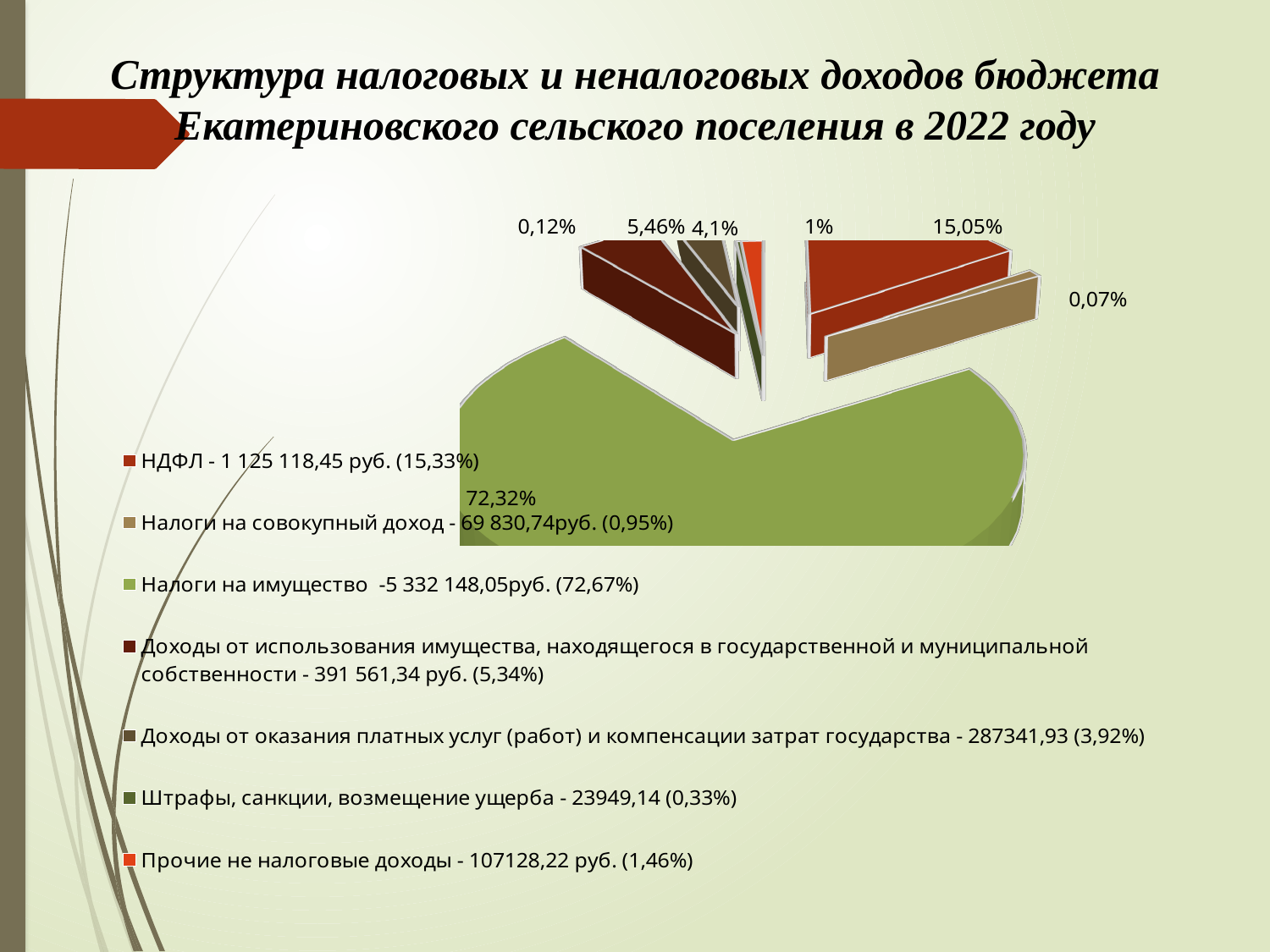
Which is larger according to the legend: the share of НДФЛ or the share of Прочие не налоговые доходы? НДФЛ According to the legend, what percentage is given for Налоги на совокупный доход? 0,95% How many categories does the legend of the pie chart list? 7 According to the legend, what amount is given for Штрафы, санкции, возмещение ущерба? 23949,14 What is the title of the slide containing the pie chart? Структура налоговых и неналоговых доходов бюджета Екатериновского сельского поселения в 2022 году According to the legend, what amount in rubles is given for НДФЛ? 1 125 118,45 руб. What data label is shown on the largest slice of the pie chart? 72,32% Which category has the largest slice in the pie chart? Налоги на имущество What is the smallest percentage data label shown on the pie chart? 0,07% What kind of chart is shown on the slide? pie chart According to the legend, what percentage is given for Доходы от использования имущества, находящегося в государственной и муниципальной собственности? 5,34% According to the legend, what amount is given for Прочие не налоговые доходы? 107128,22 руб.